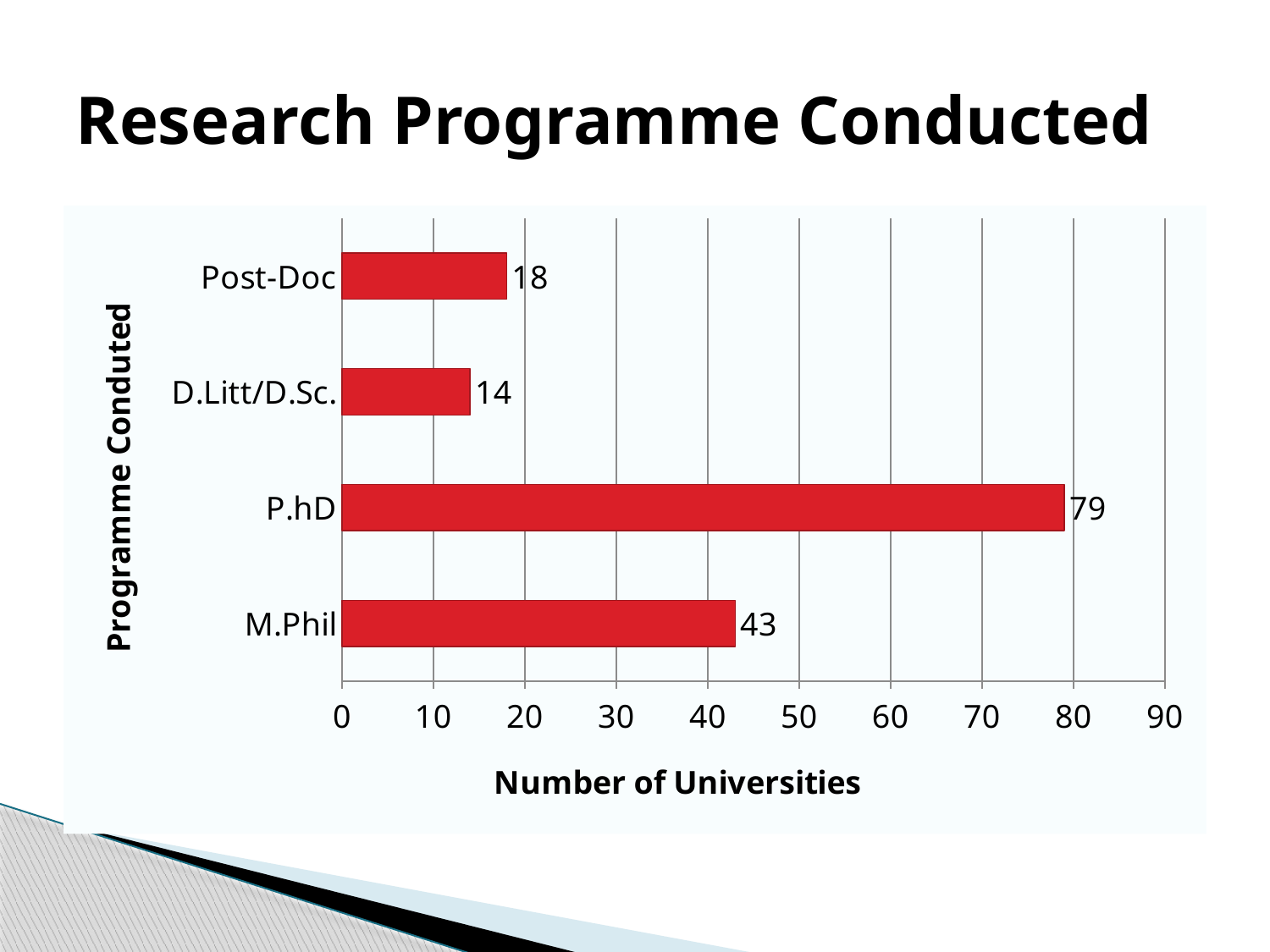
How many programme categories are shown in the chart? 4 What is the value for M.Phil? 43 Which has a larger value, M.Phil or Post-Doc? M.Phil What is the value for D.Litt/D.Sc.? 14 What type of chart is shown on the slide? Bar chart What is the number of universities for Post-Doc? 18 What is the difference between the values for Post-Doc and D.Litt/D.Sc.? 4 How many universities conduct P.hD programmes? 79 Which programme has the lowest number of universities? D.Litt/D.Sc. What is the label of the horizontal axis? Number of Universities Which programme has the highest number of universities? P.hD What is the difference between the values for P.hD and M.Phil? 36